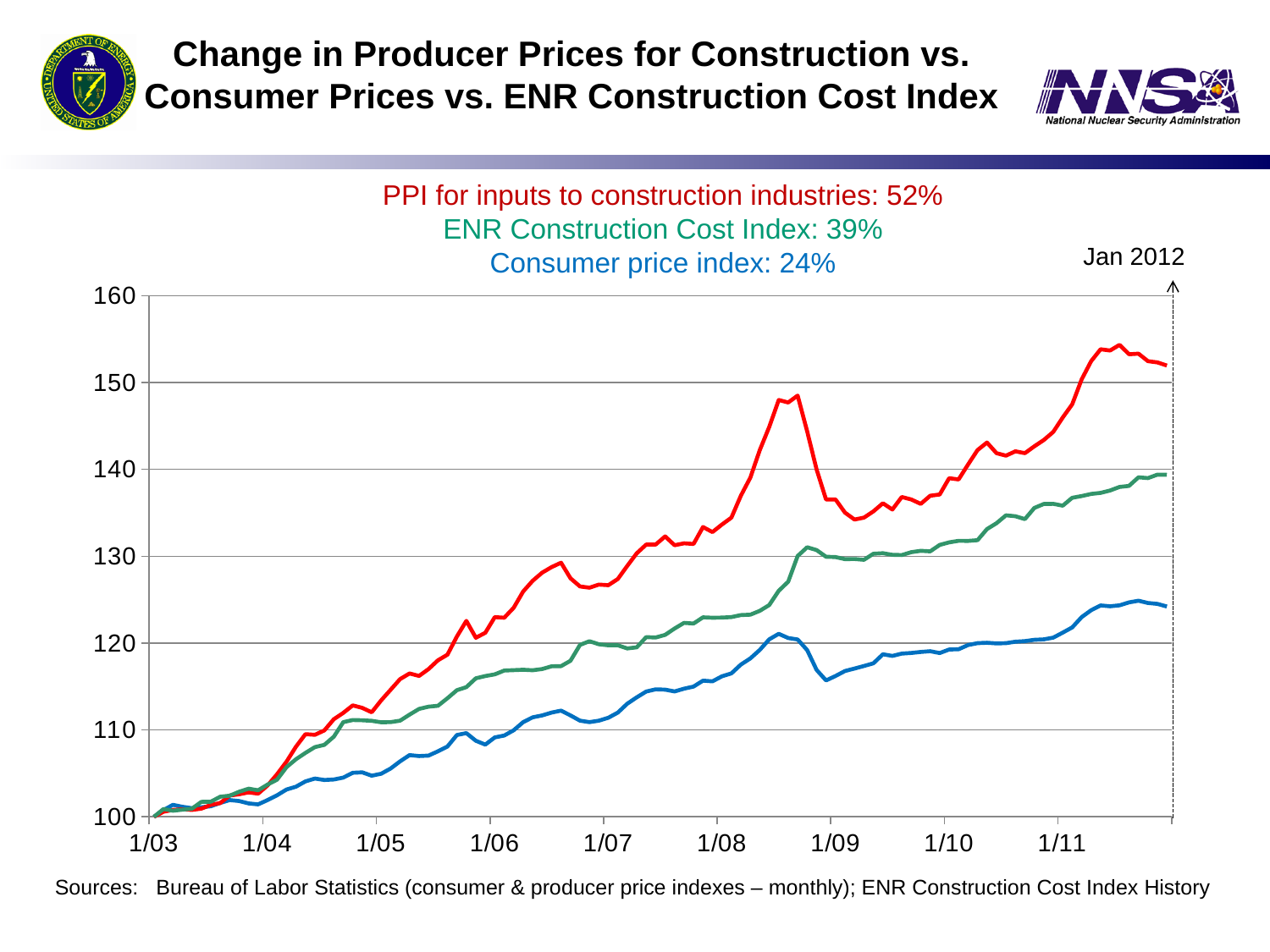
Which index shows the largest change over the period? PPI for inputs to construction industries What colour is the line for the PPI for inputs to construction industries? red What kind of chart is shown on the slide? line chart How many percentage points larger is the PPI change than the ENR Construction Cost Index change? 13 percentage points Is the value of the Consumer price index line at 1/09 greater or less than 120? less What is the change shown for the PPI for inputs to construction industries? 52% Do the three lines generally rise or fall from 1/03 to Jan 2012? rise What is the change shown for the ENR Construction Cost Index? 39% Which index shows the smallest change over the period? Consumer price index What is the change shown for the Consumer price index? 24% How many data series are plotted on the chart? 3 Is the value of the PPI line at 1/09 greater or less than 140? less